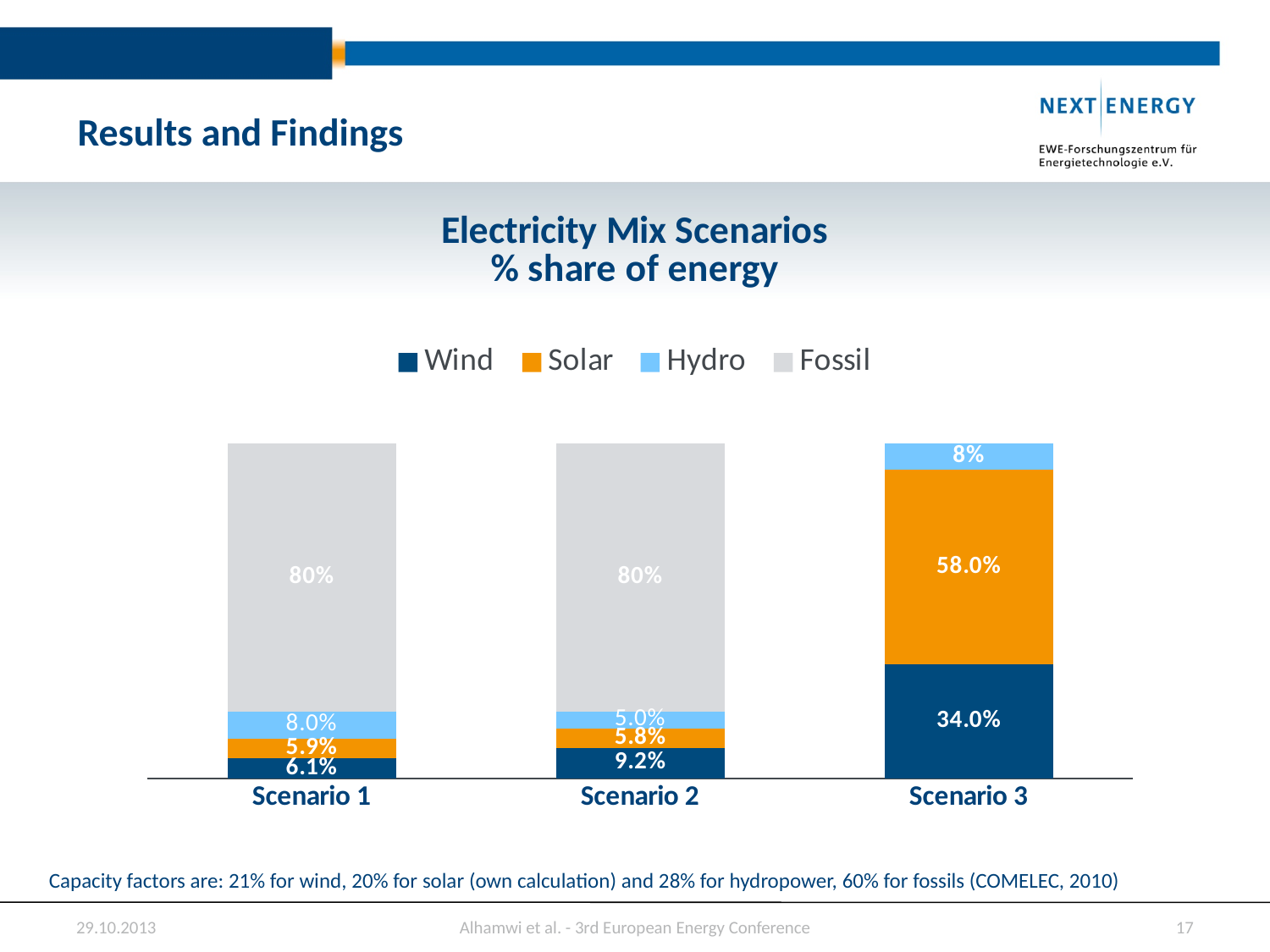
What is the Hydro share in Scenario 2? 5.0% What is the Solar share in Scenario 3? 58.0% Which scenario has the highest Wind share? Scenario 3 What kind of chart is shown? Stacked bar chart How many series does the legend list? 4 What is the Wind share in Scenario 1? 6.1% Which scenario has the lowest Solar share? Scenario 2 What is the total of the stacked bar for Scenario 3? 100% Is the Wind share larger in Scenario 2 or in Scenario 1? Scenario 2 How many scenarios are shown on the x axis? 3 How much larger is the Wind share in Scenario 3 than in Scenario 1? 27.9 percentage points What is the Fossil share in Scenario 2? 80%